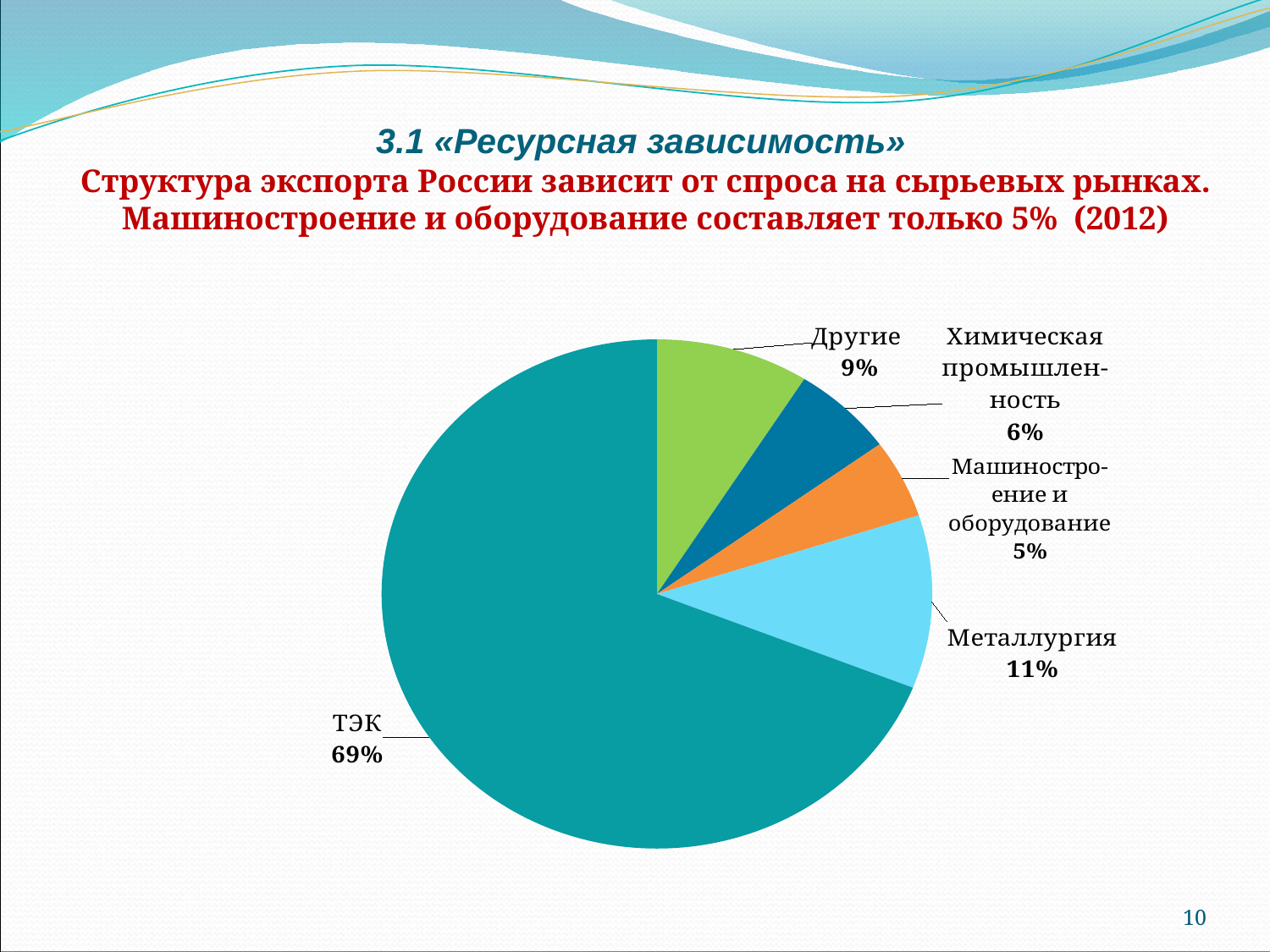
What kind of chart is shown on the slide? Pie chart Which is larger, the share of Другие or the share of Химическая промышленность? Другие What colour is the ТЭК slice? Teal What is the value shown for Машиностроение и оборудование? 5% What share of the pie does ТЭК account for? 69% What is the value shown for Химическая промышленность? 6% What is the value shown for Другие? 9% How many categories are shown in the pie chart? 5 What is the value shown for Металлургия? 11% What is the difference between the shares of ТЭК and Металлургия? 58% Which category has the largest share of the pie? ТЭК Which category has the smallest share of the pie? Машиностроение и оборудование